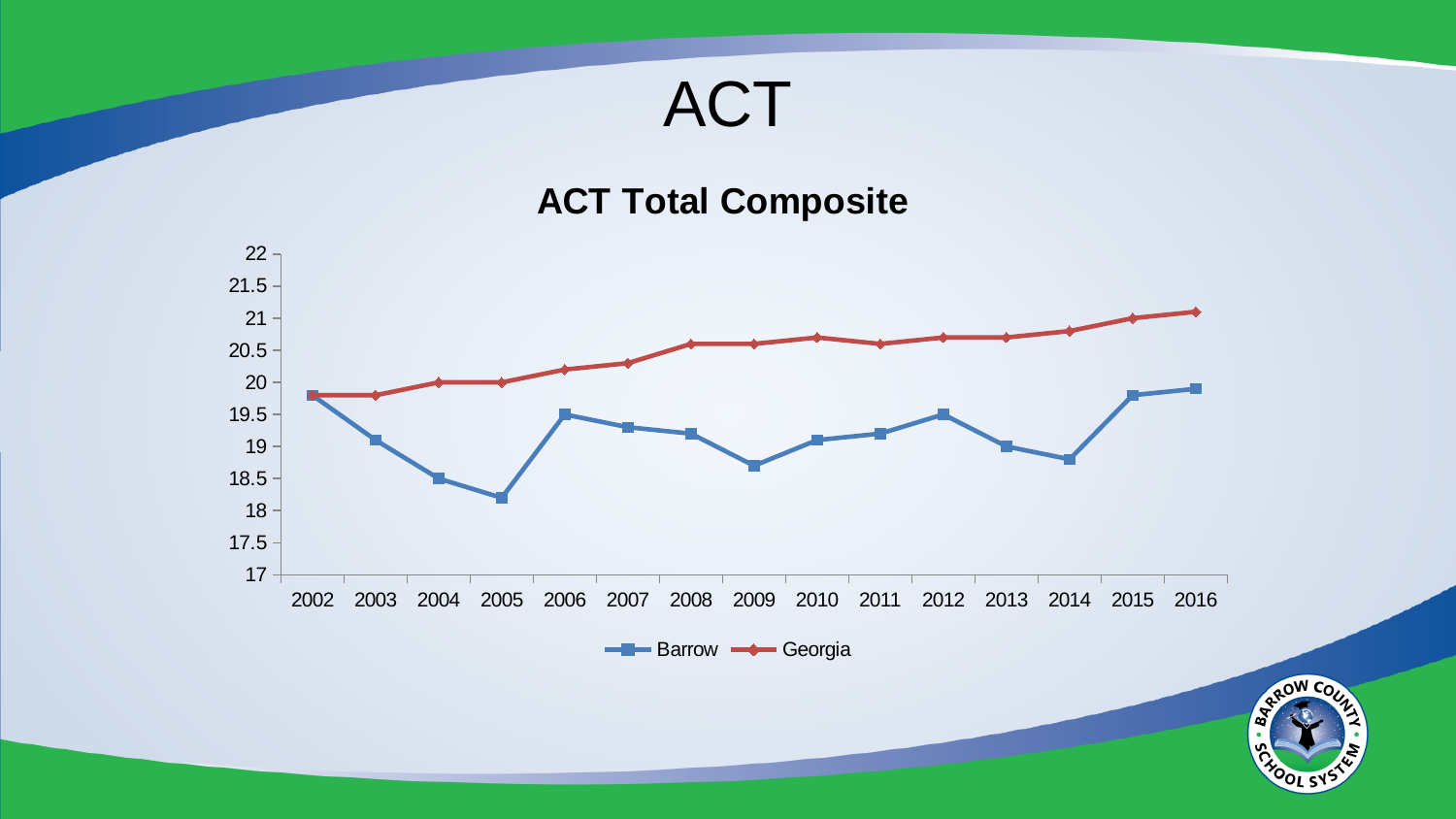
How many years are plotted along the x axis? 15 Which series is drawn in red? Georgia How many series does the legend list? 2 Is the Georgia value for 2016 greater or less than 20.5? greater In 2010, which is larger, the Barrow value or the Georgia value? Georgia Is the Barrow value for 2009 greater or less than 19? less In which year is the Georgia value highest? 2016 Is the Barrow value for 2005 greater or less than 18.5? less Does the Georgia line generally rise or fall from 2002 to 2016? rise What is the title of the chart? ACT Total Composite In which year is the Barrow value lowest? 2005 What kind of chart is shown on the slide? line chart